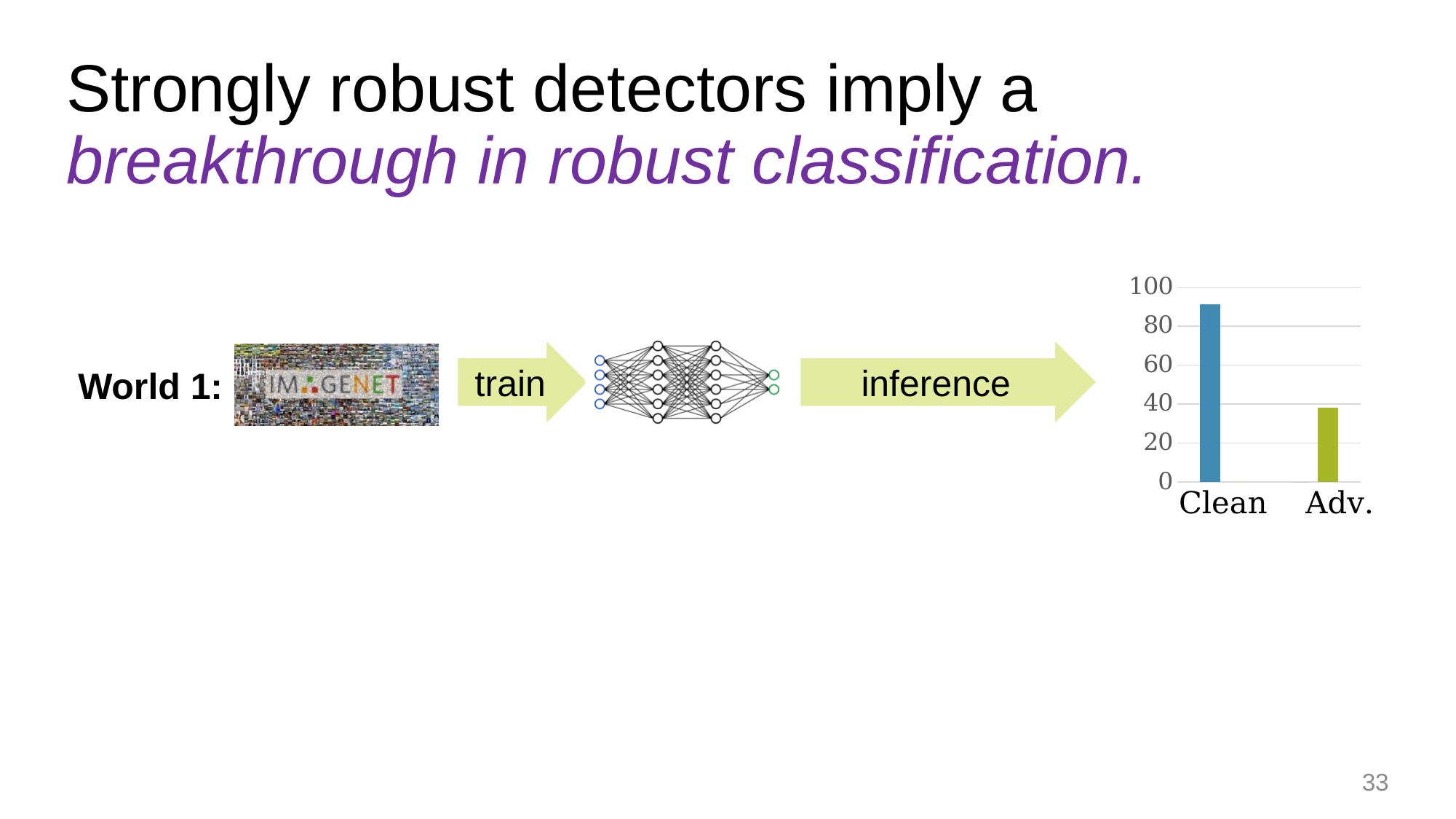
Do the values rise or fall going from Clean to Adv. along the x axis? fall Is the value for Adv. greater or less than 60? less How many categories does the bar chart show? 2 Which is larger, the value for Clean or the value for Adv.? Clean Is the value for Clean greater or less than 80? greater Which category has the highest bar in the chart? Clean What colour is the bar for Adv.? green What kind of chart is shown on the slide? bar chart Is the value for Adv. greater or less than 20? greater Which category has the lowest bar in the chart? Adv. What is the highest tick value shown on the chart's vertical axis? 100